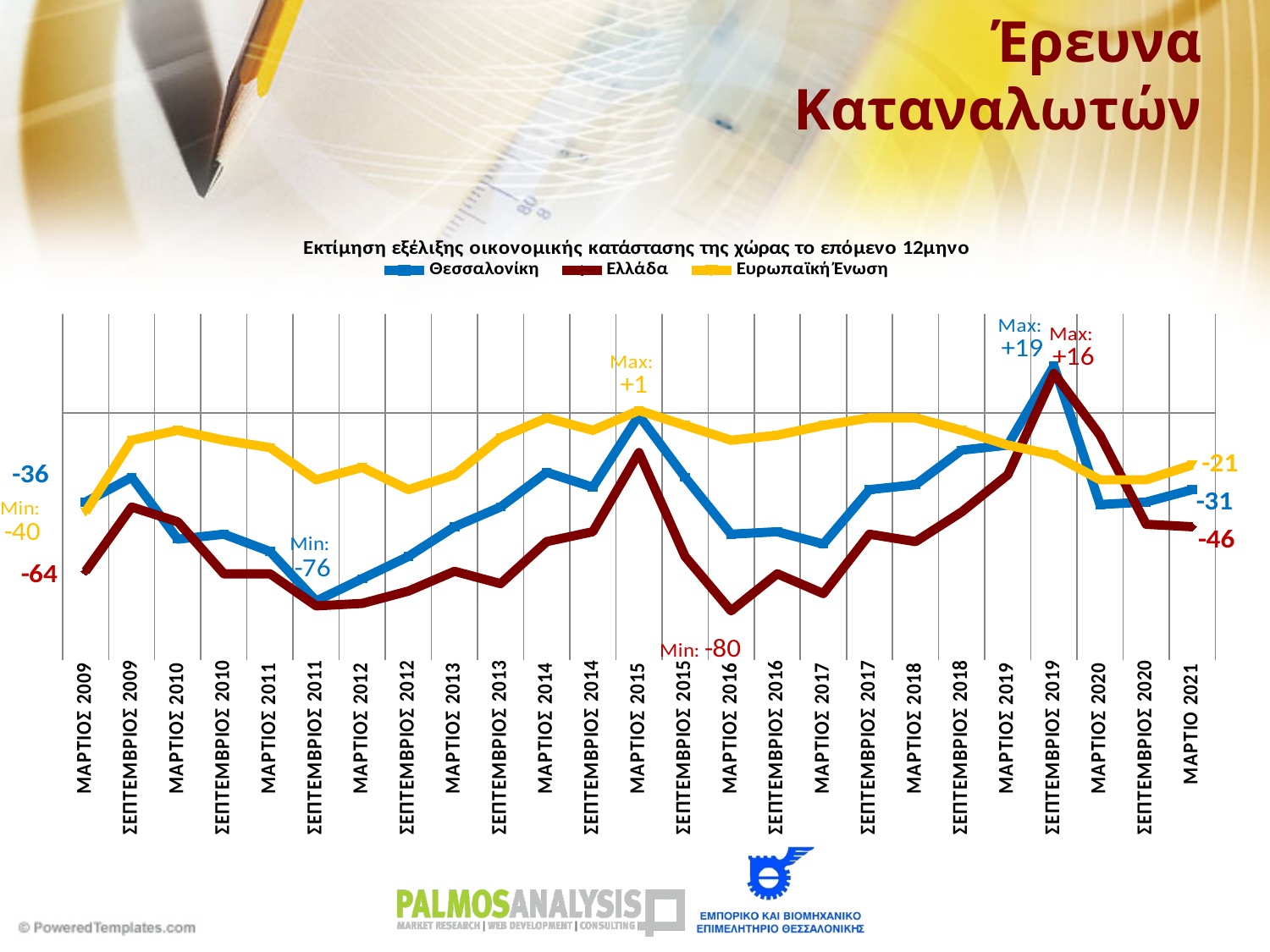
What is the difference between the Θεσσαλονίκη and Ελλάδα values in ΜΑΡΤΙΟ 2021? 15 How many series does the legend list? 3 What is the value for Ελλάδα in ΜΑΡΤΙΟ 2021? -46 What is the minimum value reached by the Ελλάδα series? -80 How many time points are shown on the x axis? 25 Which series has the higher value in ΜΑΡΤΙΟ 2021, Ευρωπαϊκή Ένωση or Ελλάδα? Ευρωπαϊκή Ένωση What is the value for Ελλάδα in ΜΑΡΤΙΟΣ 2009? -64 What kind of chart is shown on the slide? line chart What is the value for Θεσσαλονίκη in ΜΑΡΤΙΟ 2021? -31 Which series is drawn in yellow? Ευρωπαϊκή Ένωση What is the maximum value reached by the Θεσσαλονίκη series? +19 What is the value for Ευρωπαϊκή Ένωση in ΜΑΡΤΙΟ 2021? -21